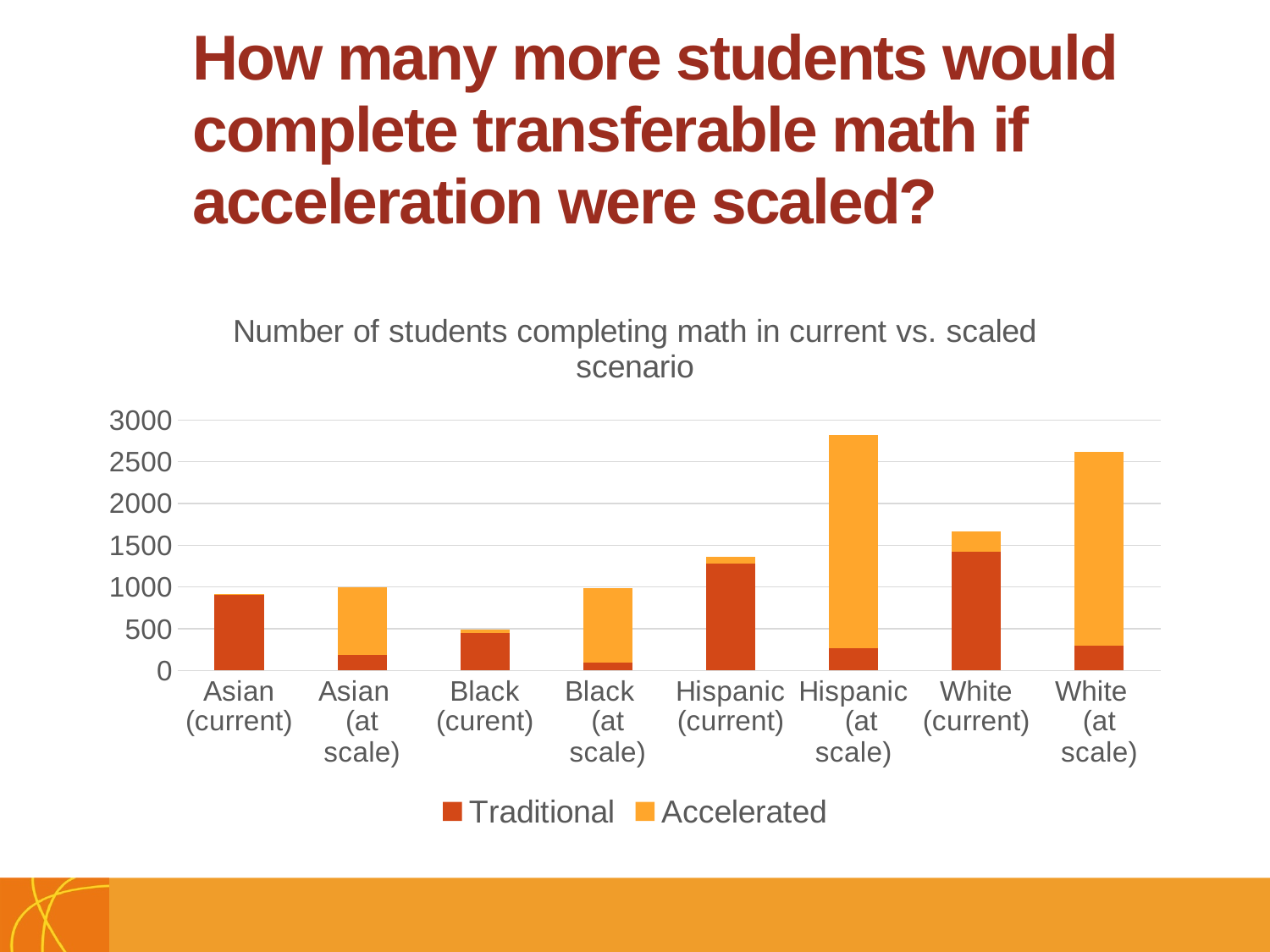
What is the title of the chart? Number of students completing math in current vs. scaled scenario Is the total for White (current) greater or less than 1500? greater Which category has the largest Traditional segment? White (current) How many series does the chart's legend list? 2 Is the value for Asian (current) greater or less than 1000? less How many categories are shown along the x axis of the chart? 8 What kind of chart is shown on the slide? Stacked bar chart Which category has the tallest total bar? Hispanic (at scale) Which total bar is taller: Hispanic (at scale) or White (at scale)? Hispanic (at scale) Which category has the shortest total bar? Black (curent) Is the total for Hispanic (at scale) greater or less than 2500? greater What are the two series named in the legend? Traditional and Accelerated